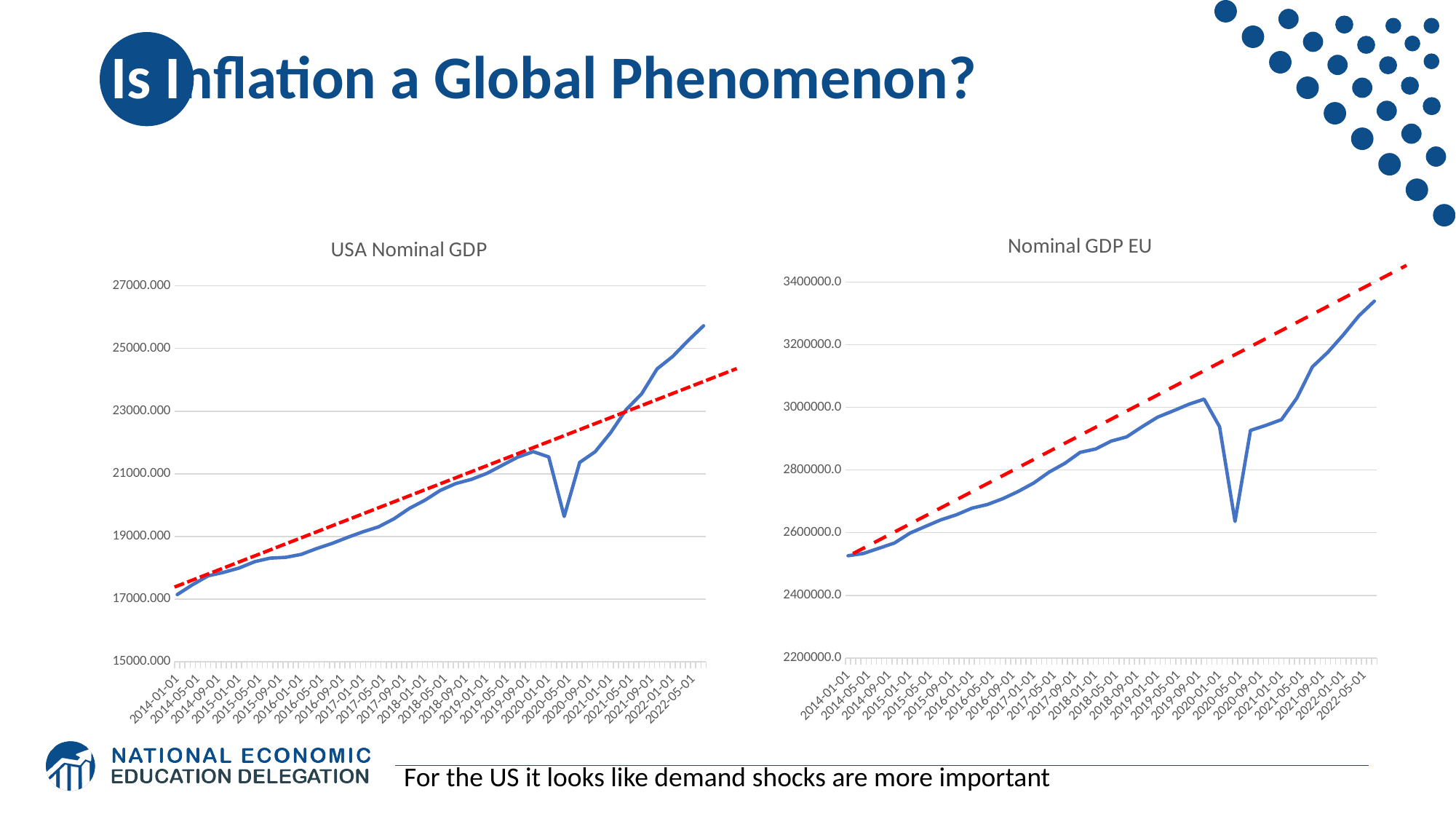
What kind of chart is the 'USA Nominal GDP' chart? line chart What is the highest value shown on the y axis of the 'Nominal GDP EU' chart? 3400000.0 In the 'USA Nominal GDP' chart, do the values generally rise or fall from 2014-01-01 to 2022-05-01? rise What kind of chart is the 'Nominal GDP EU' chart? line chart In the 'USA Nominal GDP' chart, is the value at 2014-01-01 greater or less than 19000.000? less In the 'Nominal GDP EU' chart, is the value at 2022-05-01 greater or less than 3200000.0? greater In the 'USA Nominal GDP' chart, is the value at 2022-05-01 greater or less than 25000.000? greater In the 'Nominal GDP EU' chart, do the values generally rise or fall from 2014-01-01 to 2022-05-01? rise What is the title of the chart on the left side of the slide? USA Nominal GDP